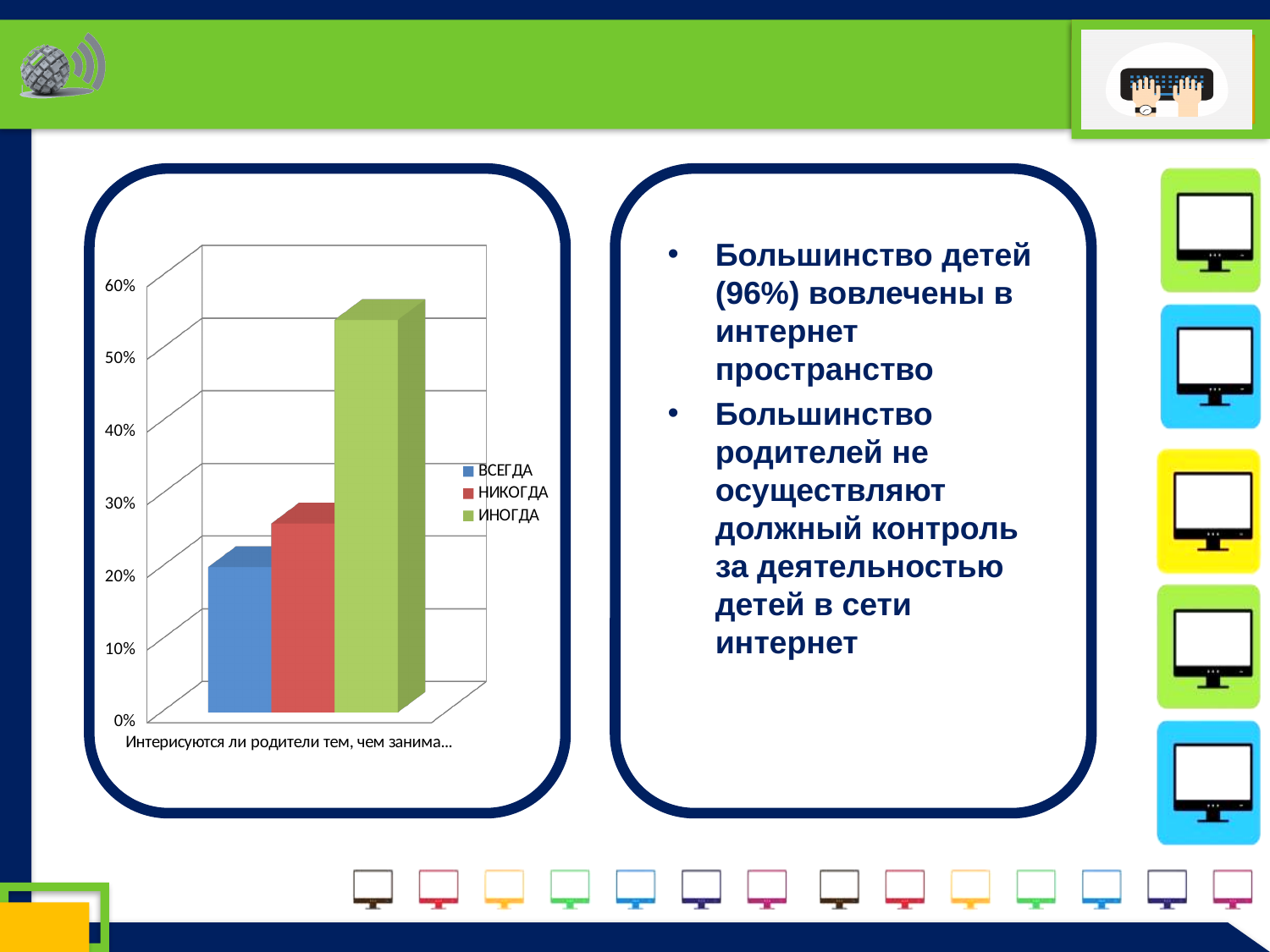
Is the value for ВСЕГДА greater or less than 10%? greater Is the value for НИКОГДА greater or less than 40%? less Which is larger, the value for ИНОГДА or the value for НИКОГДА? ИНОГДА How many series does the chart legend list? 3 Is the value for ВСЕГДА greater or less than 30%? less What colour is the bar for the ИНОГДА series? green Which series has the lowest value in the chart? ВСЕГДА What is the highest value shown on the chart's vertical axis? 60% Which series has the highest value in the chart? ИНОГДА Which is larger, the value for НИКОГДА or the value for ВСЕГДА? НИКОГДА What kind of chart is shown on the slide? bar chart